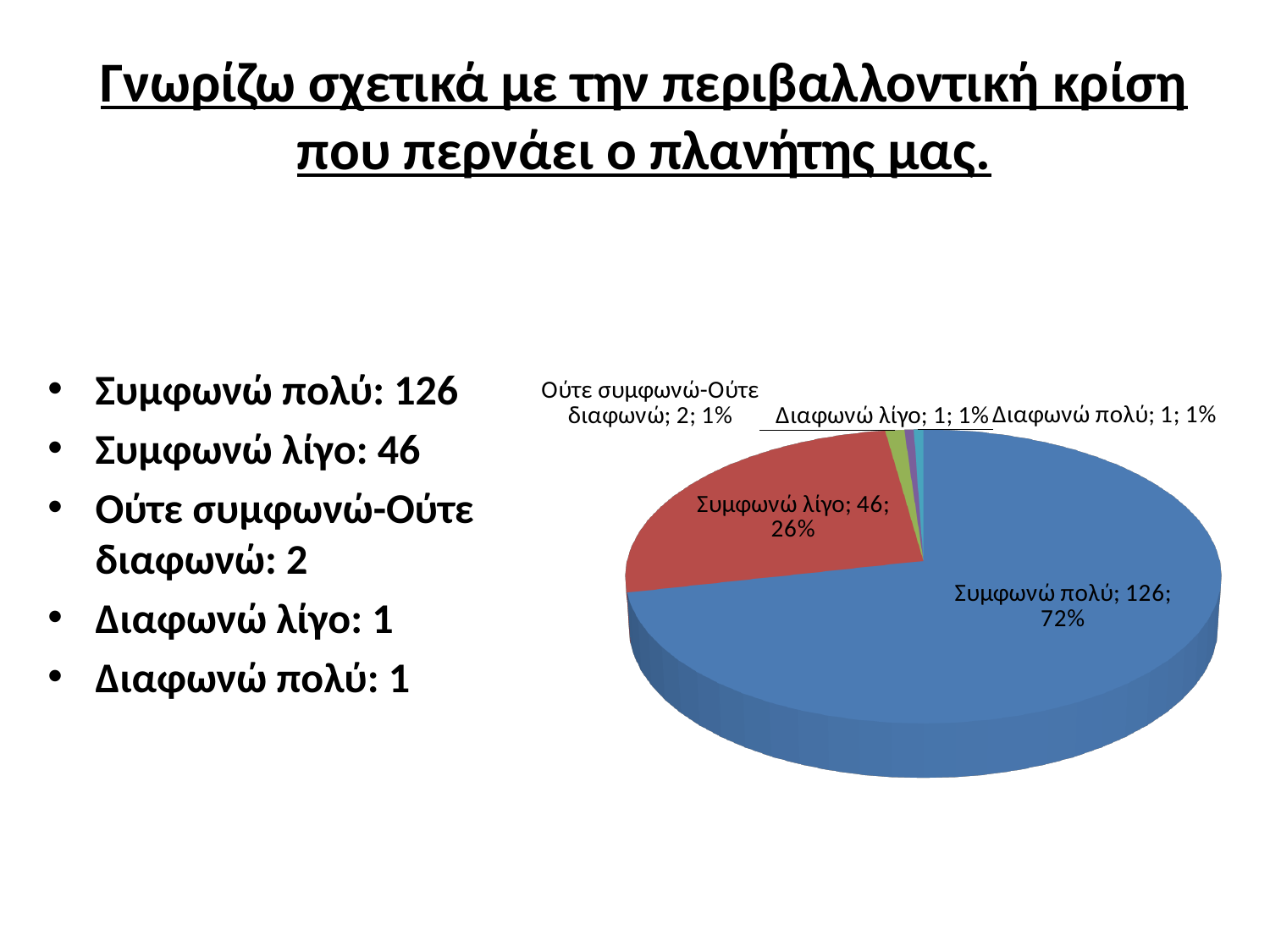
Which category has the largest slice in the pie chart? Συμφωνώ πολύ Which is larger, the value for Συμφωνώ λίγο or the value for Ούτε συμφωνώ-Ούτε διαφωνώ? Συμφωνώ λίγο What colour is the Συμφωνώ λίγο slice in the pie chart? red What is the value for Συμφωνώ πολύ in the pie chart? 126 What is the difference between the values for Συμφωνώ πολύ and Συμφωνώ λίγο? 80 What is the value for Ούτε συμφωνώ-Ούτε διαφωνώ in the pie chart? 2 What is the total of all the values shown in the pie chart? 176 What is the value for Συμφωνώ λίγο in the pie chart? 46 What percentage share does the Συμφωνώ λίγο slice have? 26% How many slices does the pie chart have? 5 What percentage share does the Συμφωνώ πολύ slice have? 72% What kind of chart is shown on the slide? pie chart